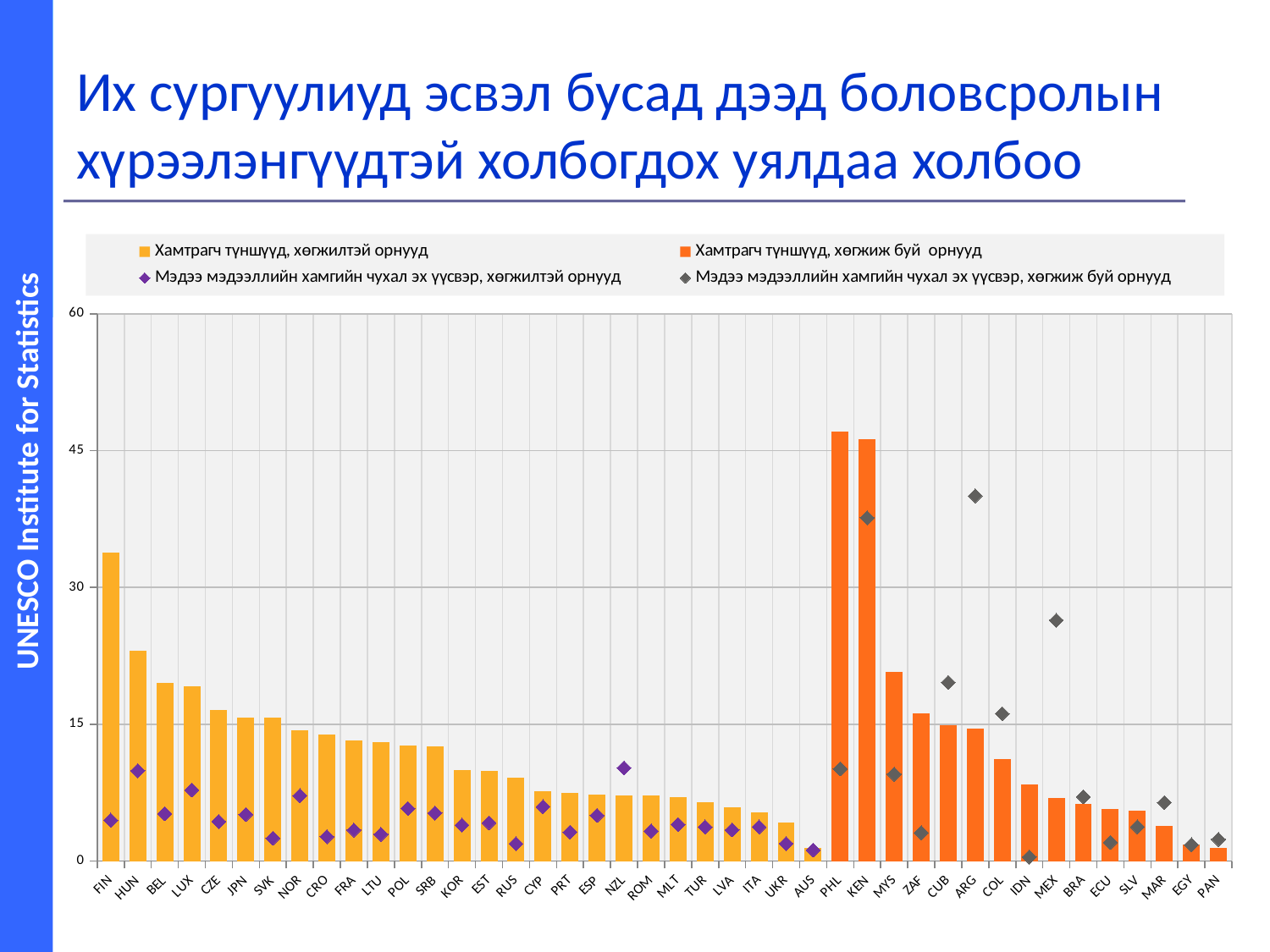
Is the diamond marker value for ARG greater or less than 30? greater Which has the taller bar, FIN or HUN? FIN Which country has the tallest bar among the yellow (developed countries) bars? FIN How many series does the legend list? 4 Is the bar value for PHL greater or less than 45? greater What kind of chart is shown on the slide? bar chart with diamond markers (combination chart) Is the bar value for FIN greater or less than 30? greater Do the yellow bars rise or fall from FIN to AUS along the x axis? fall How many countries are shown along the x axis? 42 What colour are the bars for the developing countries (хөгжиж буй орнууд)? orange Which country has the lowest diamond marker value? IDN